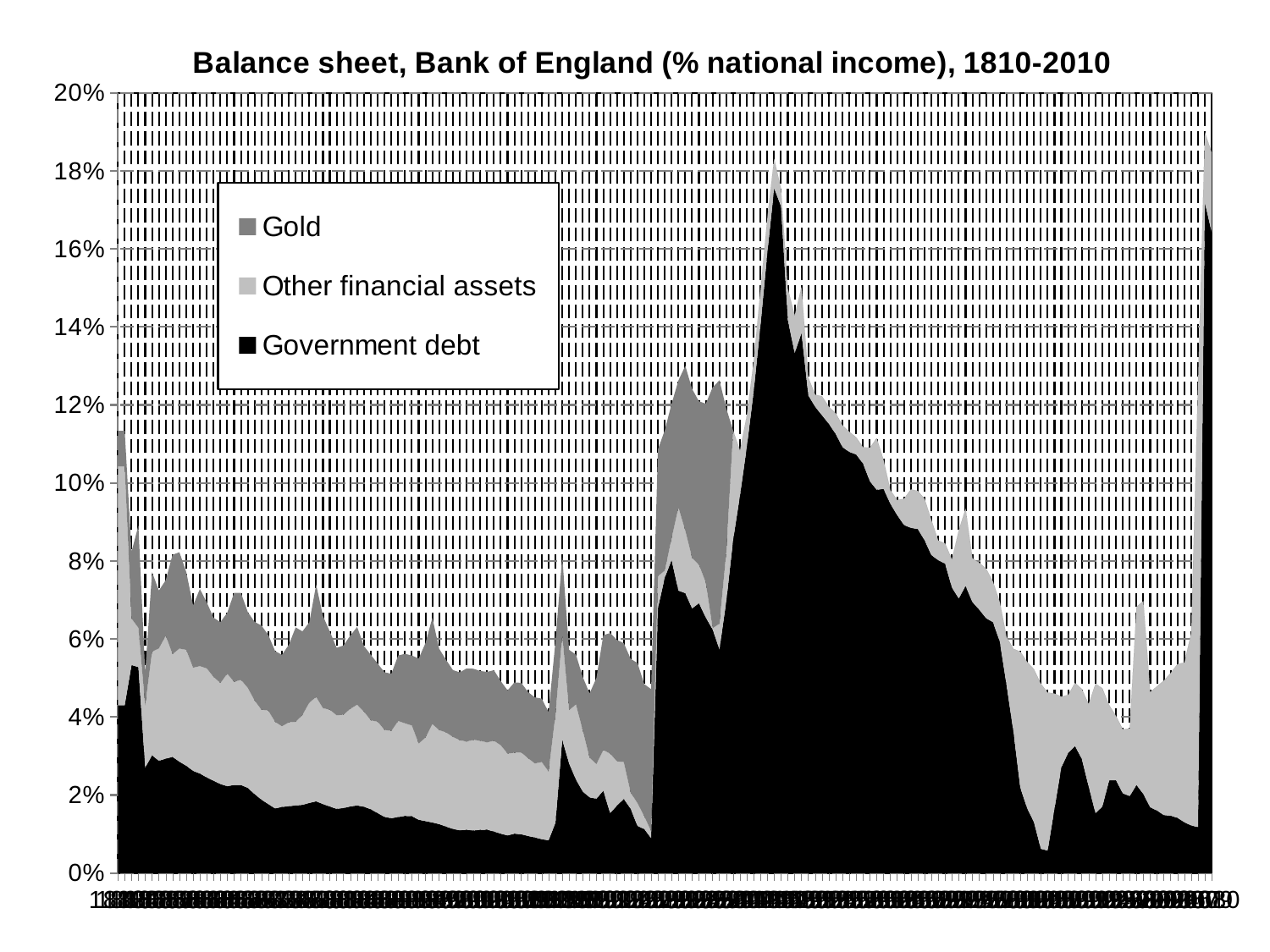
What kind of chart is shown on the slide? Stacked area chart Is the highest point of the total balance sheet greater or less than 16%? greater What is the title of the chart? Balance sheet, Bank of England (% national income), 1810-2010 Is the highest point of the total balance sheet greater or less than 20%? less How many series does the legend list? 3 Which series is plotted in black at the bottom of the stack? Government debt